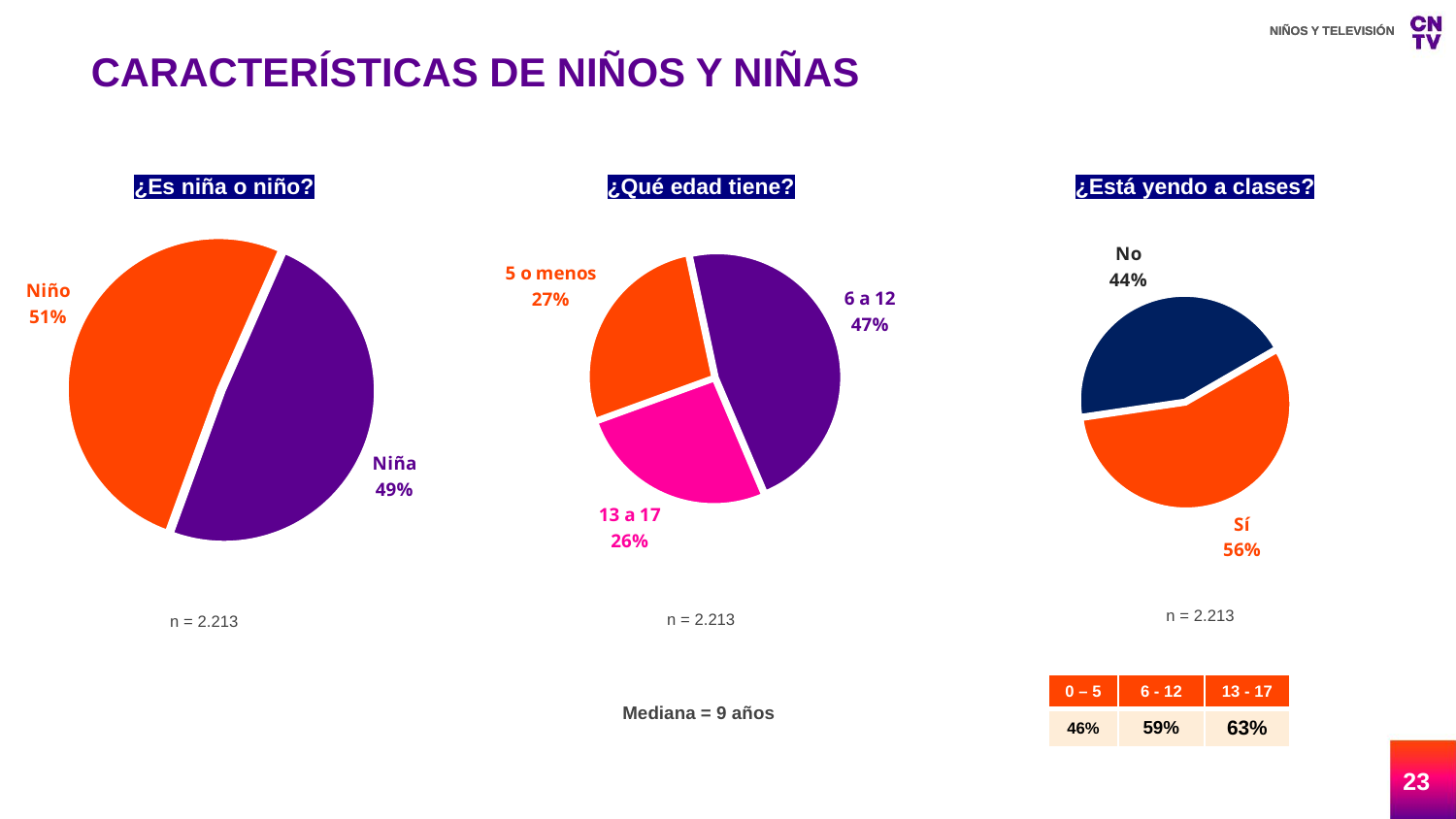
In the '¿Qué edad tiene?' chart, what is the value for '5 o menos'? 27% In the '¿Qué edad tiene?' chart, which age group has the smallest share? 13 a 17 What kind of chart is used for '¿Es niña o niño?'? Pie chart In the '¿Está yendo a clases?' chart, what is the difference between Sí and No? 12% In the '¿Qué edad tiene?' chart, which age group has the largest share? 6 a 12 In the '¿Qué edad tiene?' chart, what is the difference between '6 a 12' and '13 a 17'? 21% In the '¿Es niña o niño?' chart, what share is Niña? 49% In the '¿Está yendo a clases?' chart, which is larger, Sí or No? Sí In the '¿Es niña o niño?' chart, what share is Niño? 51% In the '¿Qué edad tiene?' chart, how many slices does the pie have? 3 In the '¿Qué edad tiene?' chart, what is the value for '6 a 12'? 47% In the '¿Está yendo a clases?' chart, what is the value for Sí? 56%